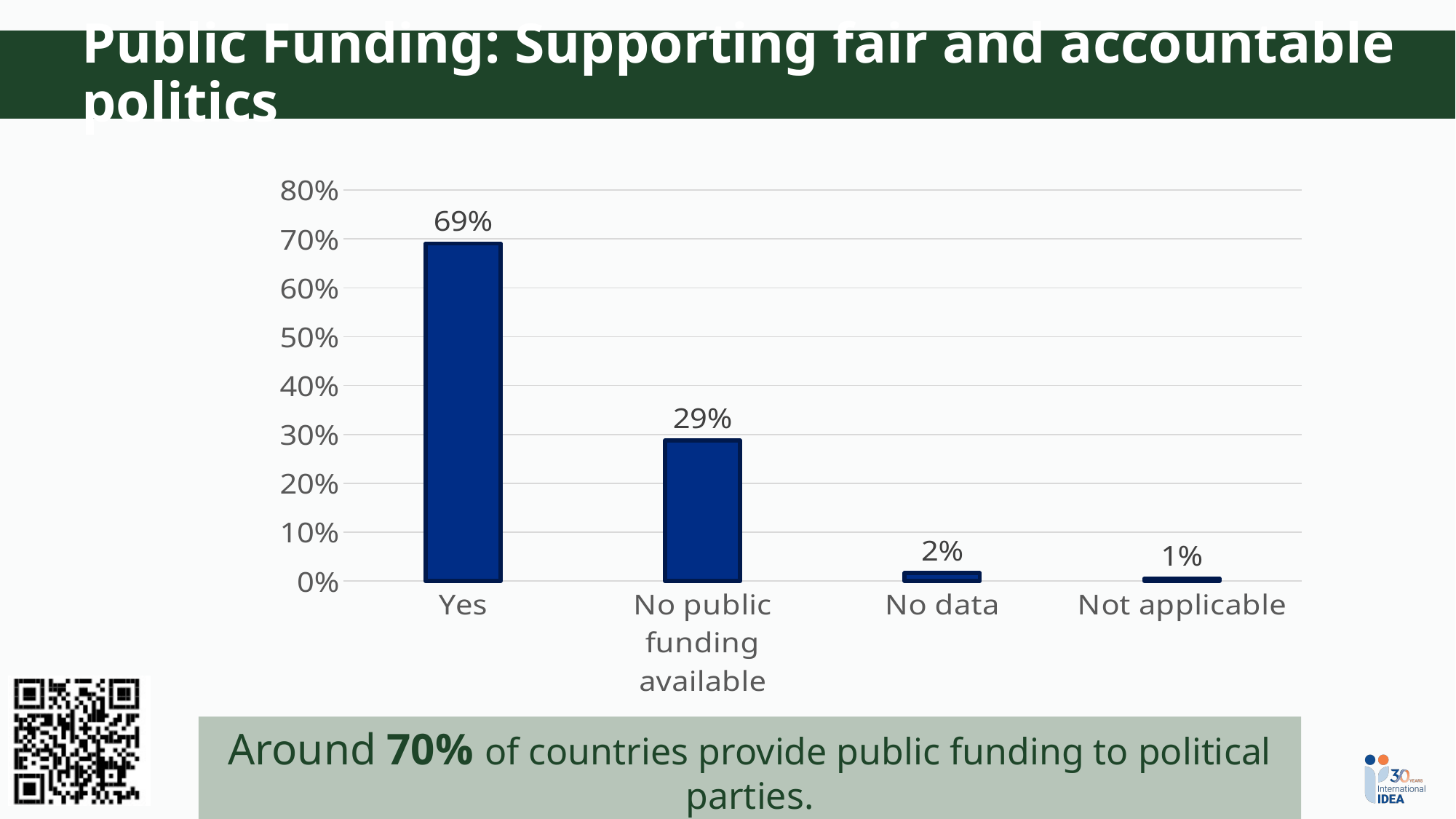
What is the highest value shown on the y axis? 80% Which category has the lowest value? Not applicable What is the value for Yes? 69% What is the value for Not applicable? 1% How many categories are shown on the x axis? 4 What is the difference between the values for Yes and No public funding available? 40% Which category has the highest value? Yes What is the value for No data? 2% Is the value for Yes greater or less than 60%? greater What kind of chart is shown on the slide? bar chart Which is larger, the value for No data or the value for Not applicable? No data What is the value for No public funding available? 29%